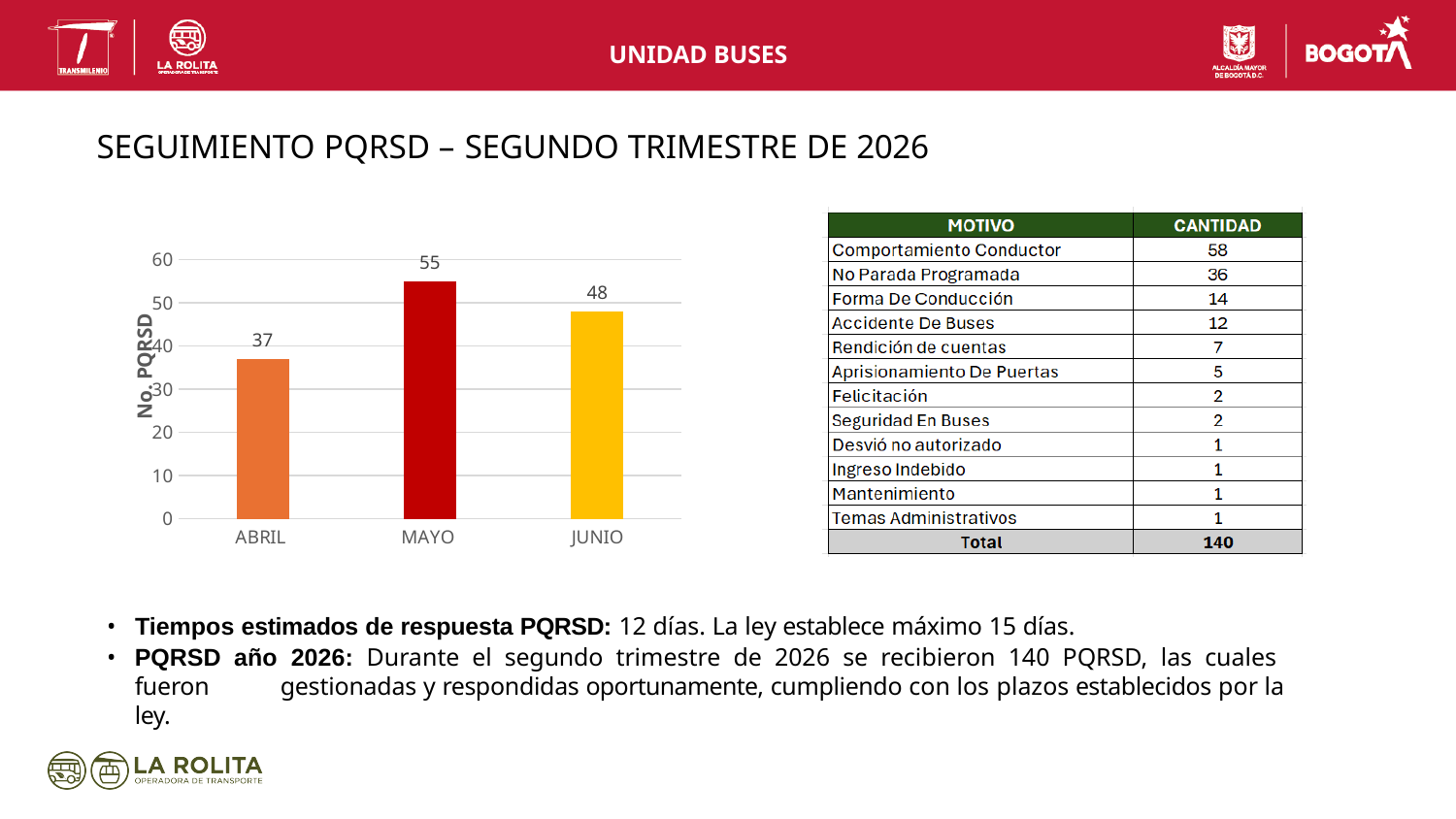
Is the value for JUNIO in the bar chart greater or less than 40? greater Which month has the lowest value in the bar chart? ABRIL Which is larger in the bar chart, the value for JUNIO or the value for ABRIL? JUNIO What is the label of the vertical axis of the bar chart? No. PQRSD What is the value for JUNIO in the bar chart? 48 What is the value for ABRIL in the bar chart? 37 How many months are shown in the bar chart? 3 Which month has the highest value in the bar chart? MAYO What is the value for MAYO in the bar chart? 55 What is the difference between the values for MAYO and JUNIO in the bar chart? 7 What is the difference between the values for MAYO and ABRIL in the bar chart? 18 What kind of chart is shown on the slide? bar chart